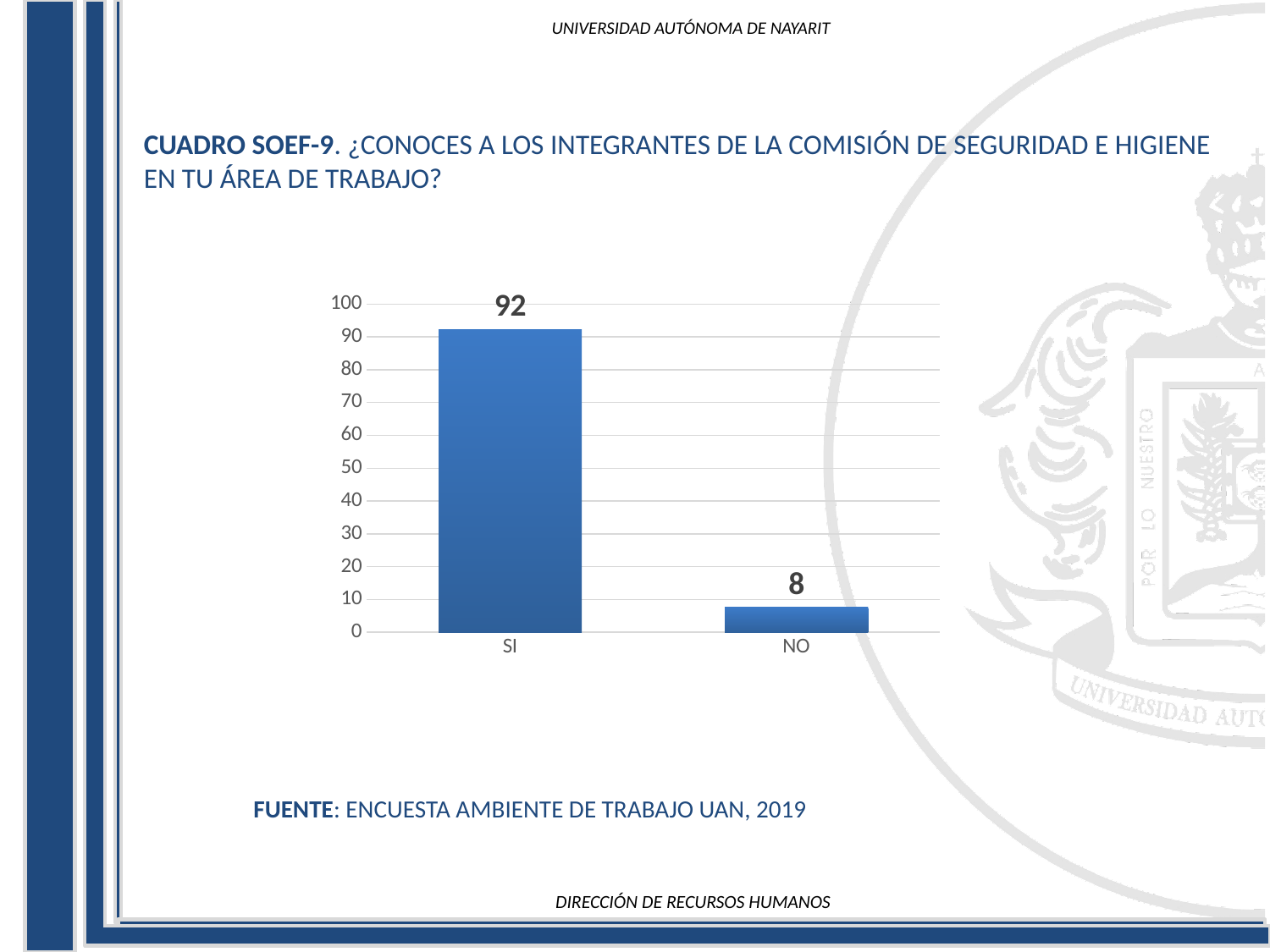
What is the value for SI? 92 What kind of chart is shown on the slide? bar chart Which is larger, the value for SI or the value for NO? SI How many categories are shown on the x axis? 2 What is the maximum value shown on the vertical axis? 100 What is the difference between the values for SI and NO? 84 What is the total of the two values shown in the chart? 100 What is the value for NO? 8 Is the value for NO greater or less than 10? less Which category has the lowest value? NO Is the value for SI greater or less than 90? greater Which category has the highest value? SI